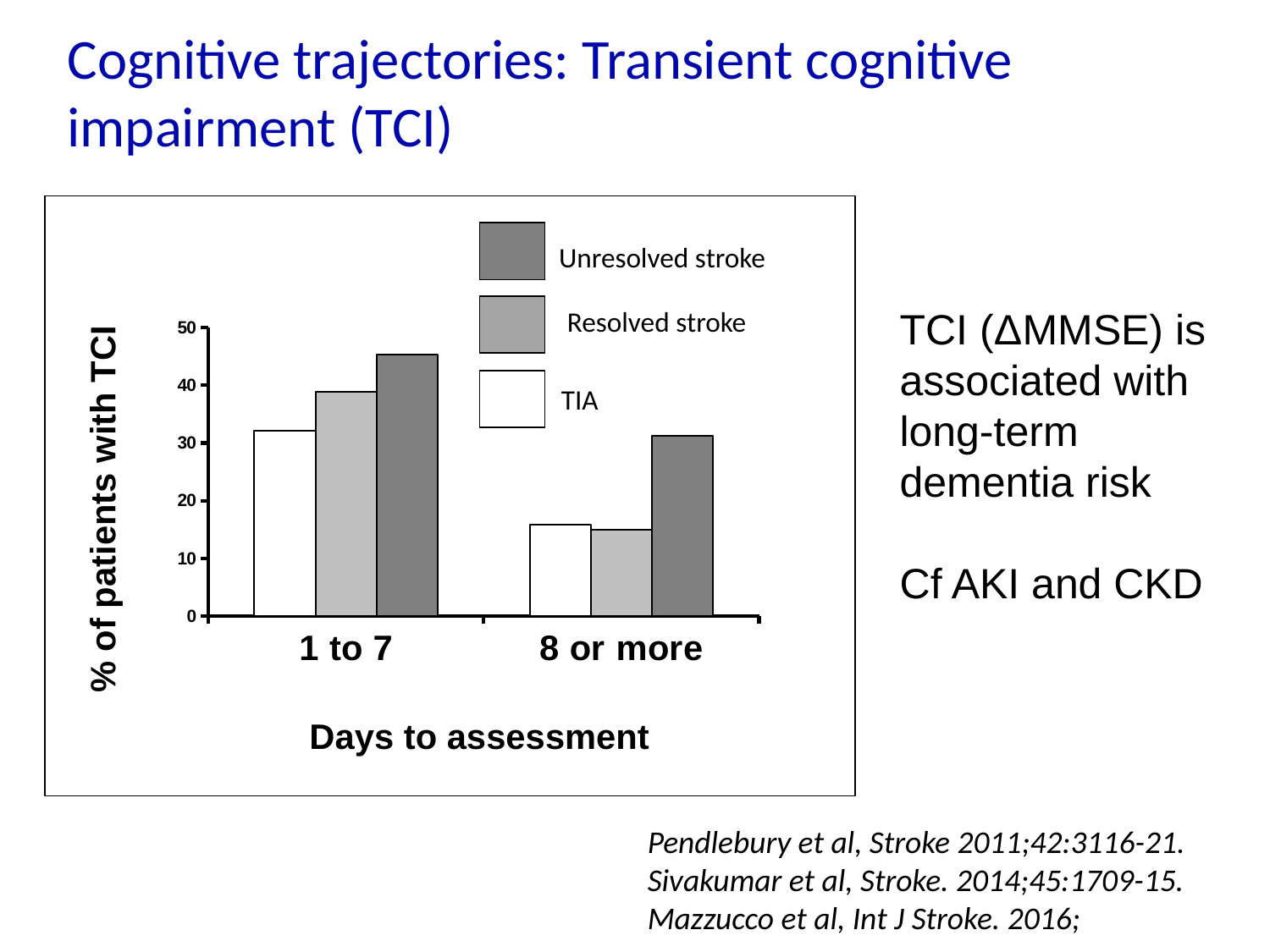
In the '8 or more' days category, which series has the highest percentage of patients with TCI? Unresolved stroke How many series does the chart's legend list? 3 What is the label on the y axis of the chart? % of patients with TCI Is the value for Unresolved stroke at '8 or more' days greater or less than 40? less Is the value for Unresolved stroke at '1 to 7' days greater or less than 40? greater How many categories are shown on the x axis of the chart? 2 What kind of chart is shown on the slide? bar chart Is the value for Resolved stroke at '1 to 7' days greater or less than 30? greater In the '1 to 7' days category, which series has the lowest percentage of patients with TCI? TIA For Unresolved stroke, which category has the larger value: '1 to 7' or '8 or more'? 1 to 7 In the '1 to 7' days category, which series has the highest percentage of patients with TCI? Unresolved stroke